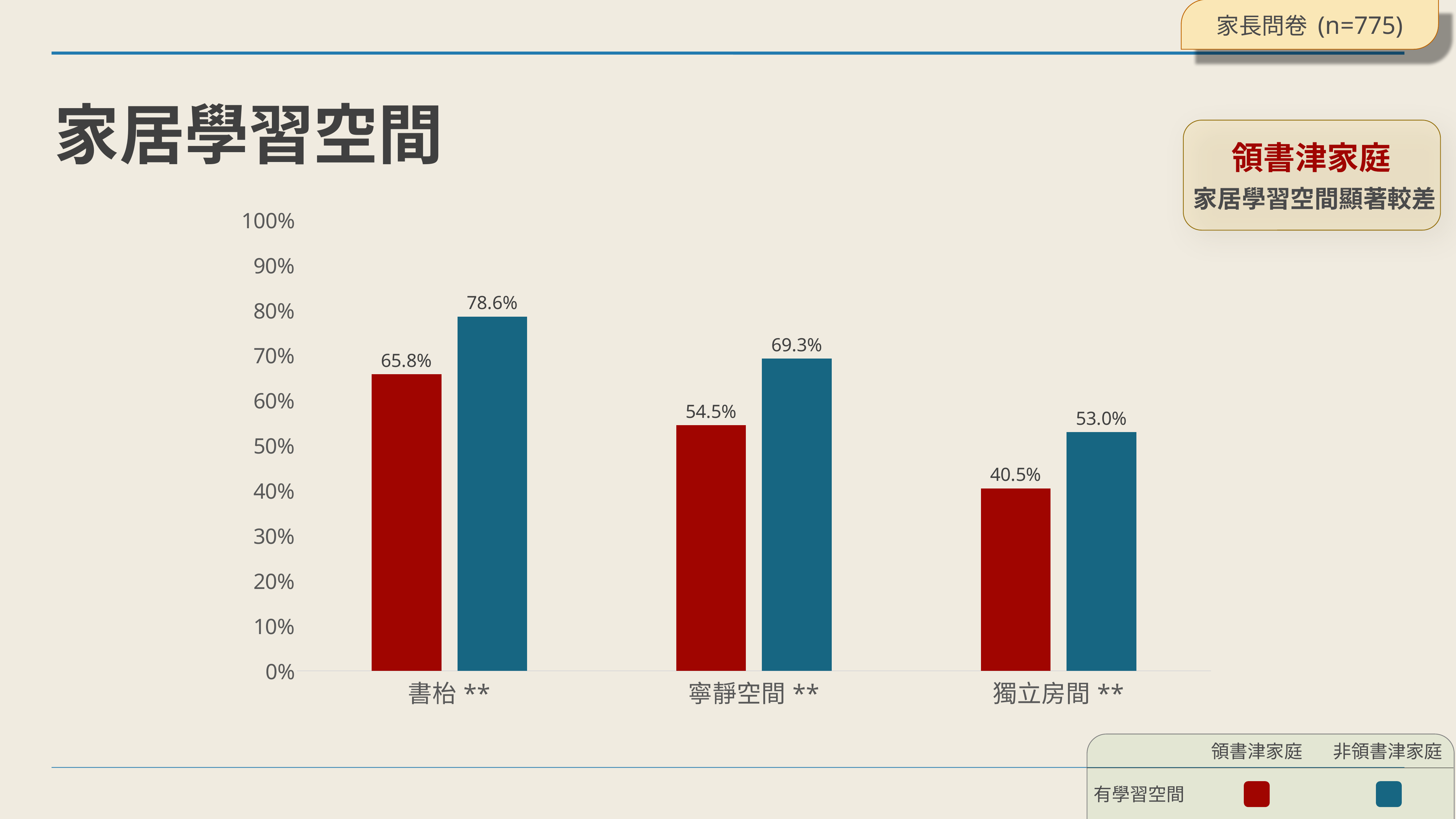
How many series does the legend list? 2 In the 獨立房間 ** category, which series has the larger value, 領書津家庭 or 非領書津家庭? 非領書津家庭 What is the value for 非領書津家庭 in the 寧靜空間 ** category? 69.3% What is the value for 領書津家庭 in the 書枱 ** category? 65.8% What is the value for 非領書津家庭 in the 獨立房間 ** category? 53.0% Which category has the highest value for 非領書津家庭? 書枱 ** What kind of chart is shown on the slide? Bar chart Which category has the lowest value for 領書津家庭? 獨立房間 ** What is the difference between 非領書津家庭 and 領書津家庭 in the 書枱 ** category? 12.8% What is the difference between 非領書津家庭 and 領書津家庭 in the 寧靜空間 ** category? 14.8% How many categories are shown on the x axis of the chart? 3 What is the value for 領書津家庭 in the 獨立房間 ** category? 40.5%